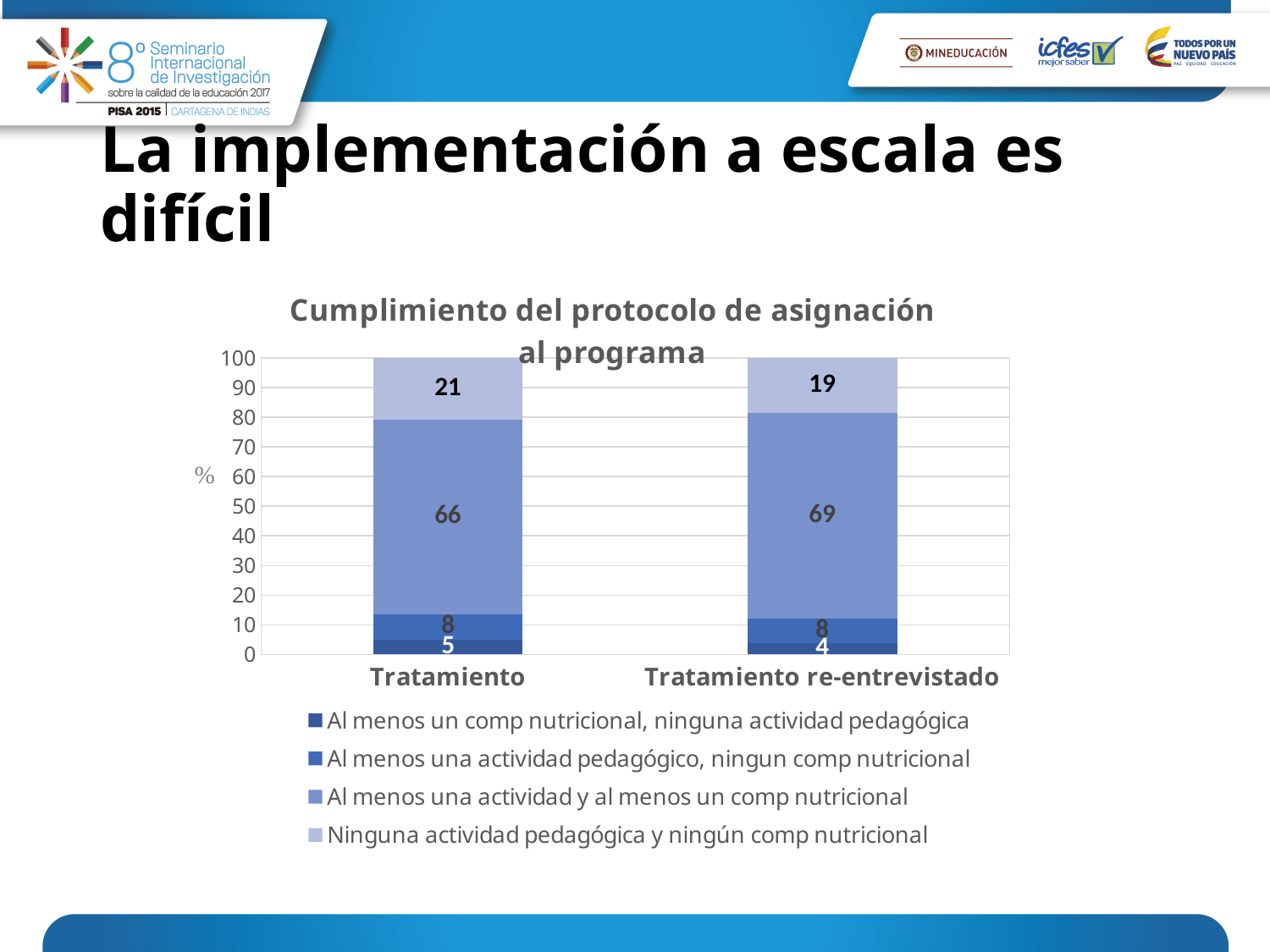
What is the value of 'Al menos una actividad y al menos un comp nutricional' for Tratamiento re-entrevistado? 69 What is the title of the chart? Cumplimiento del protocolo de asignación al programa Which category has the larger value for 'Al menos una actividad y al menos un comp nutricional'? Tratamiento re-entrevistado What is the value of 'Al menos un comp nutricional, ninguna actividad pedagógica' for Tratamiento re-entrevistado? 4 What is the total of the stacked bar for Tratamiento? 100 Which series has the largest value in the Tratamiento bar? Al menos una actividad y al menos un comp nutricional How many categories are shown on the x axis of the chart? 2 What is the value of 'Al menos una actividad y al menos un comp nutricional' for Tratamiento? 66 What is the value of 'Ninguna actividad pedagógica y ningún comp nutricional' for Tratamiento? 21 What is the difference between the 'Ninguna actividad pedagógica y ningún comp nutricional' values for Tratamiento and Tratamiento re-entrevistado? 2 What type of chart is shown on the slide? Stacked bar chart How many series does the legend list? 4